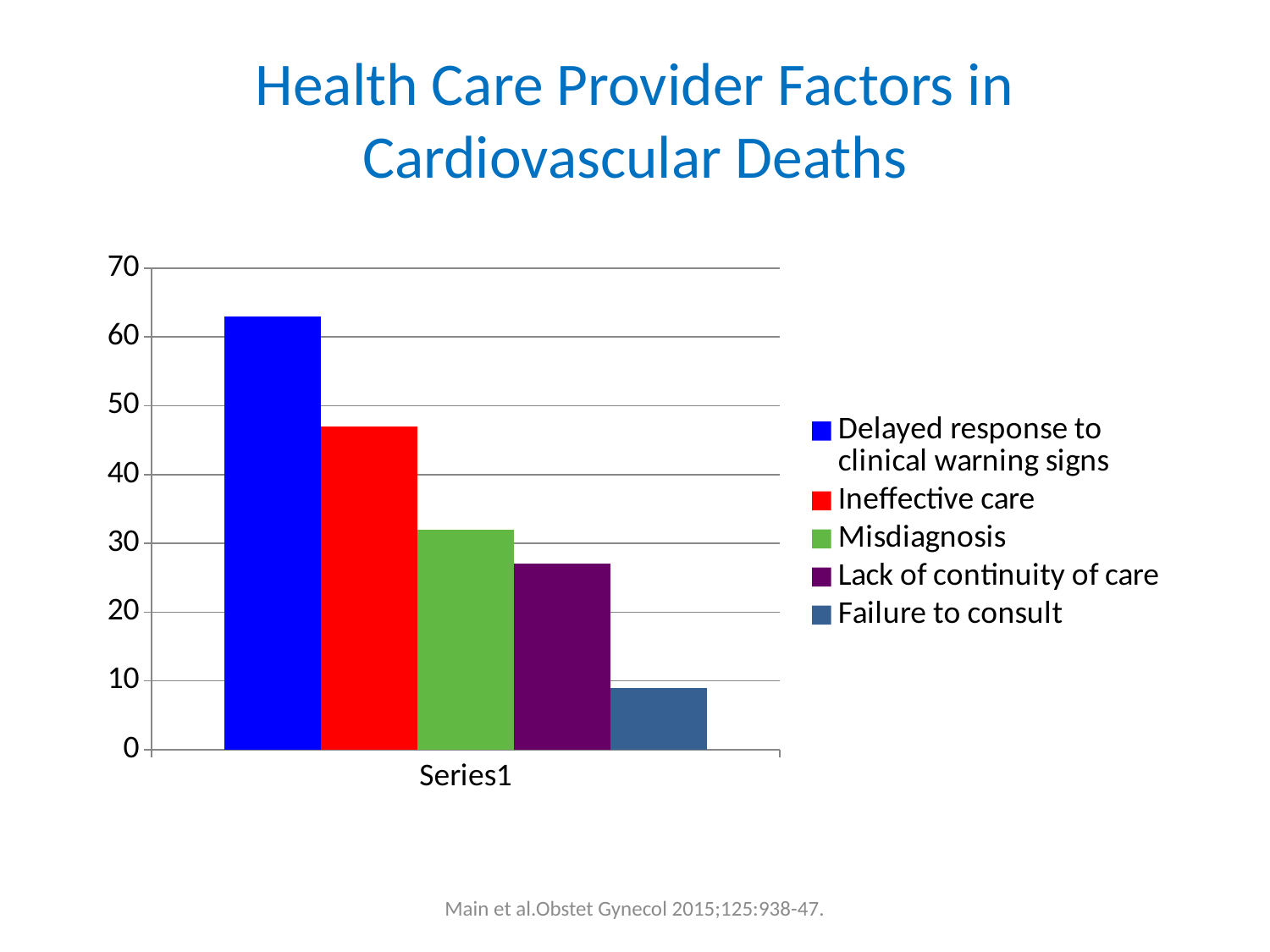
Is the value for Misdiagnosis greater or less than 30? greater Which is larger, the value for Ineffective care or the value for Misdiagnosis? Ineffective care Is the value for Ineffective care greater or less than 50? less How many entries does the legend list? 5 Is the value for Delayed response to clinical warning signs greater or less than 60? greater Which factor has the lowest bar? Failure to consult What is the title of the slide containing the chart? Health Care Provider Factors in Cardiovascular Deaths Which factor has the highest bar? Delayed response to clinical warning signs How many bars are plotted in the chart? 5 What kind of chart is shown on the slide? bar chart